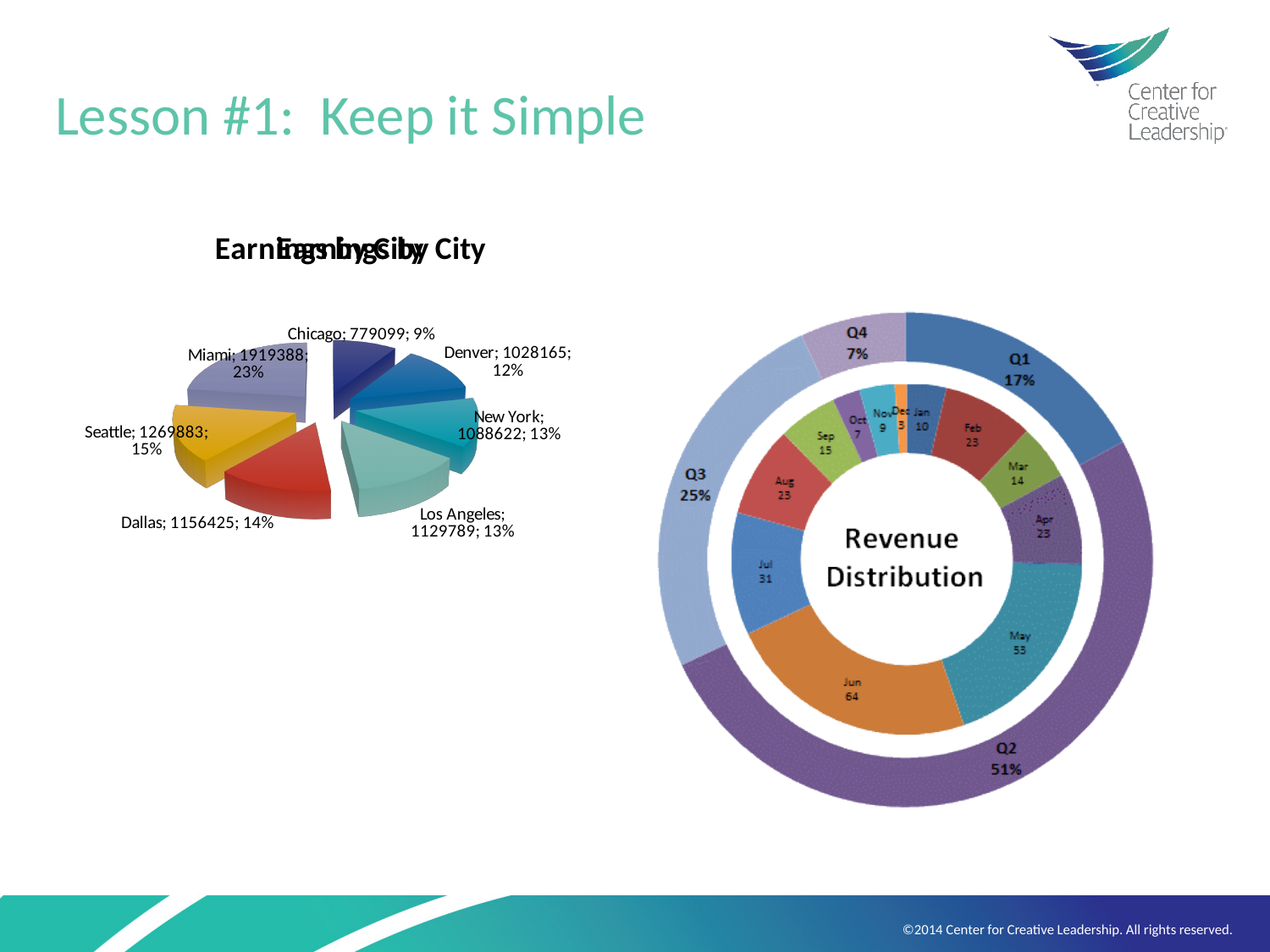
In the Earnings by City pie chart, what is the difference between the earnings of Dallas and Denver? 128260 In the Revenue Distribution chart on the right, which month has the highest value in the inner ring? Jun In the Earnings by City pie chart, which city has the smallest earnings? Chicago What type of chart is the Earnings by City chart on the left? Pie chart In the Revenue Distribution chart on the right, what percentage share does Q2 have? 51% In the Revenue Distribution chart on the right, which quarter has the smallest share? Q4 How many cities are shown in the Earnings by City pie chart? 7 In the Earnings by City pie chart, what percentage share does Seattle have? 15% In the Earnings by City pie chart, which has higher earnings, Seattle or Los Angeles? Seattle In the Revenue Distribution chart on the right, what is the value for Jun in the inner ring? 64 In the Earnings by City pie chart, which city has the largest earnings? Miami In the Earnings by City pie chart, what is the value for Miami? 1919388